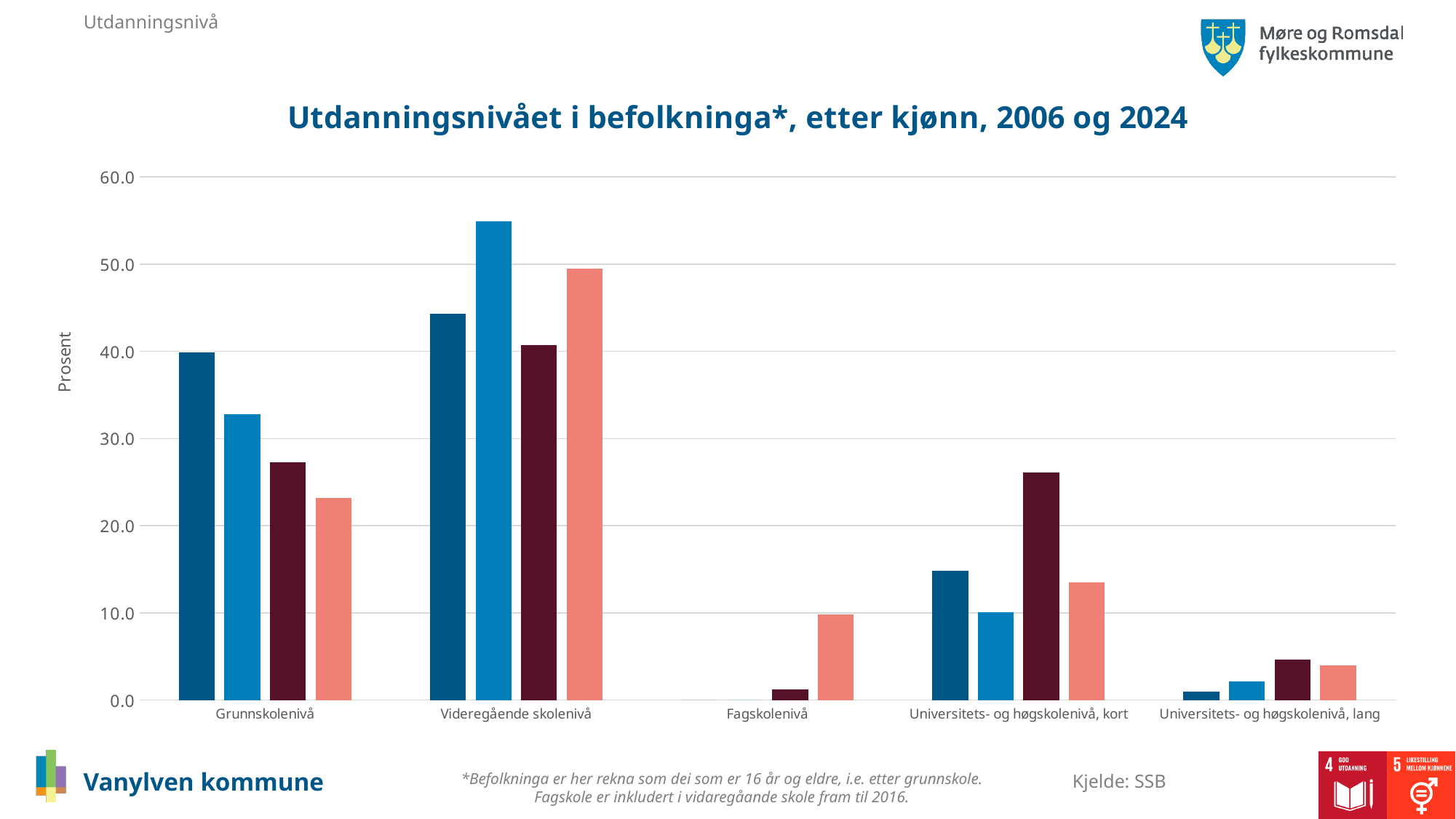
Are all the bars for Universitets- og høgskolenivå, lang greater or less than 10.0? less Which category contains the tallest bar in the chart? Videregående skolenivå Is the value of the light blue bar for Videregående skolenivå greater or less than 50.0? greater Is the value of the light blue bar for Grunnskolenivå greater or less than 30.0? greater How many bars are plotted for the Grunnskolenivå category? 4 How many education-level categories are shown on the x axis? 5 Which is larger: the dark blue bar for Grunnskolenivå or the dark blue bar for Videregående skolenivå? Videregående skolenivå What kind of chart is shown on the slide? bar chart What is the label on the vertical axis of the chart? Prosent What is the title of the chart? Utdanningsnivået i befolkninga*, etter kjønn, 2006 og 2024